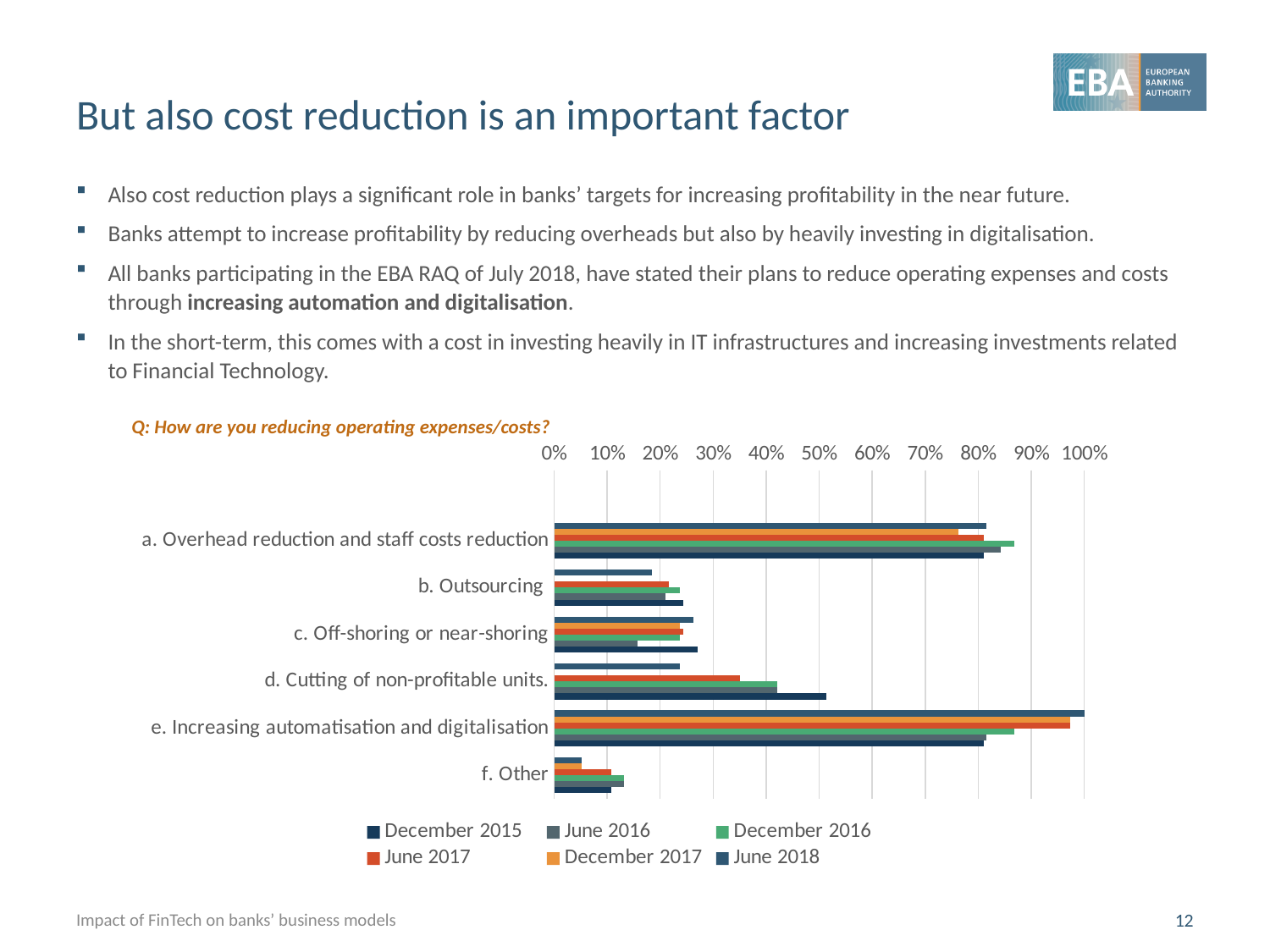
How many categories (response options) are shown on the chart? 6 What kind of chart is shown on the slide? bar chart Is the June 2018 value for 'e. Increasing automatisation and digitalisation' greater or less than 90%? greater Which category has the longest bar on the chart? e. Increasing automatisation and digitalisation Which category has the shortest bars on the chart? f. Other How many series does the chart legend list? 6 Is the June 2018 value for 'f. Other' greater or less than 10%? less Is the June 2018 value for 'd. Cutting of non-profitable units.' greater or less than 30%? less For June 2018, which is larger: the value for 'e. Increasing automatisation and digitalisation' or for 'a. Overhead reduction and staff costs reduction'? e. Increasing automatisation and digitalisation What question is the chart answering, as stated above it? Q: How are you reducing operating expenses/costs?